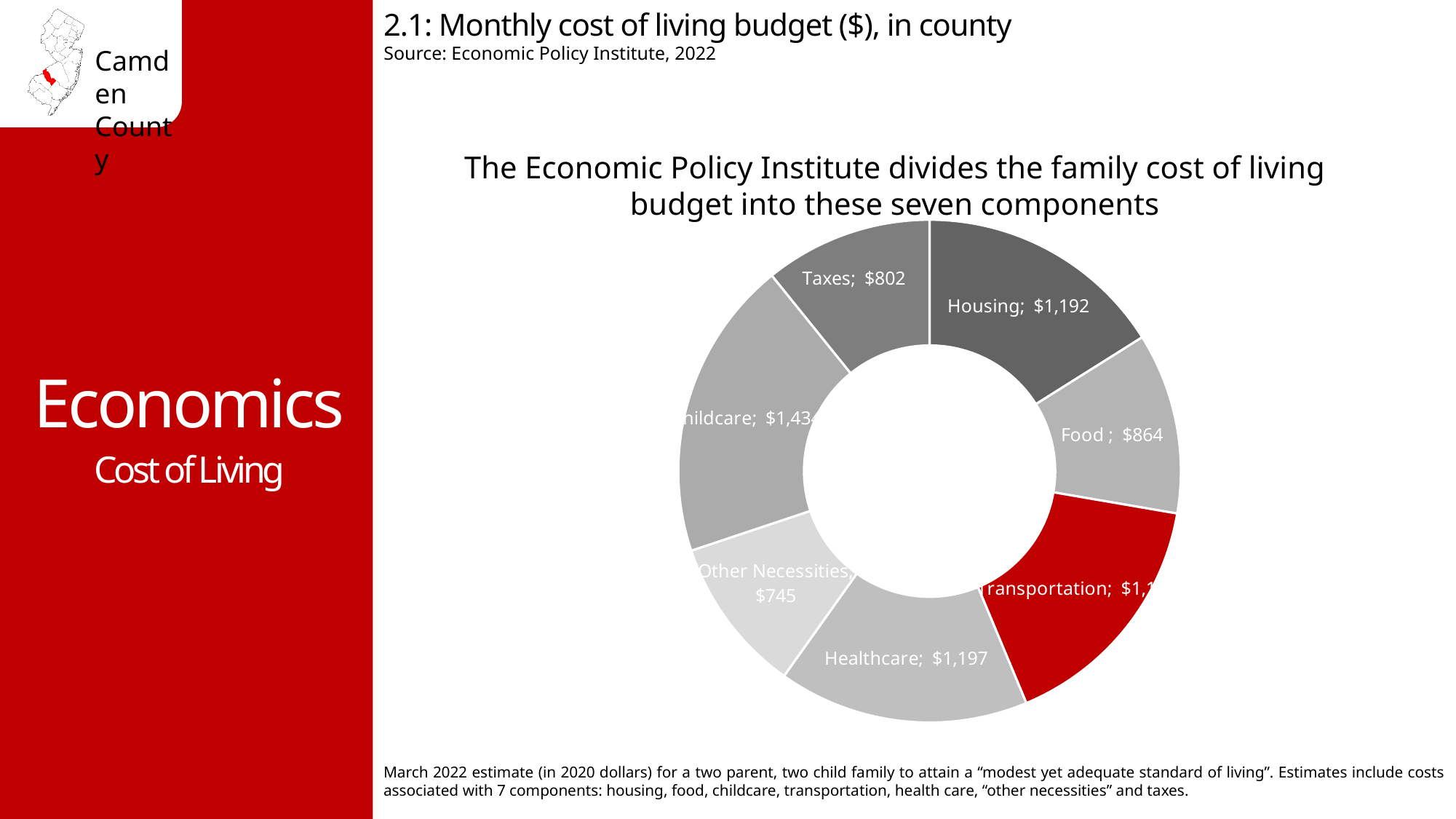
What type of chart is shown on the slide? Doughnut (pie) chart What is the monthly cost for Housing shown on the chart? $1,192 How many components are shown in the chart? 7 Which component has the smallest monthly cost in the chart? Other Necessities What is the monthly cost for Healthcare shown on the chart? $1,197 Which is larger, the monthly cost for Healthcare or for Housing? Healthcare What is the difference between the Taxes and Other Necessities monthly costs? $57 Which component has the largest monthly cost in the chart? Childcare What is the monthly cost for Other Necessities shown on the chart? $745 What is the difference between the Housing and Food monthly costs? $328 What is the monthly cost for Taxes shown on the chart? $802 What is the monthly cost for Food shown on the chart? $864